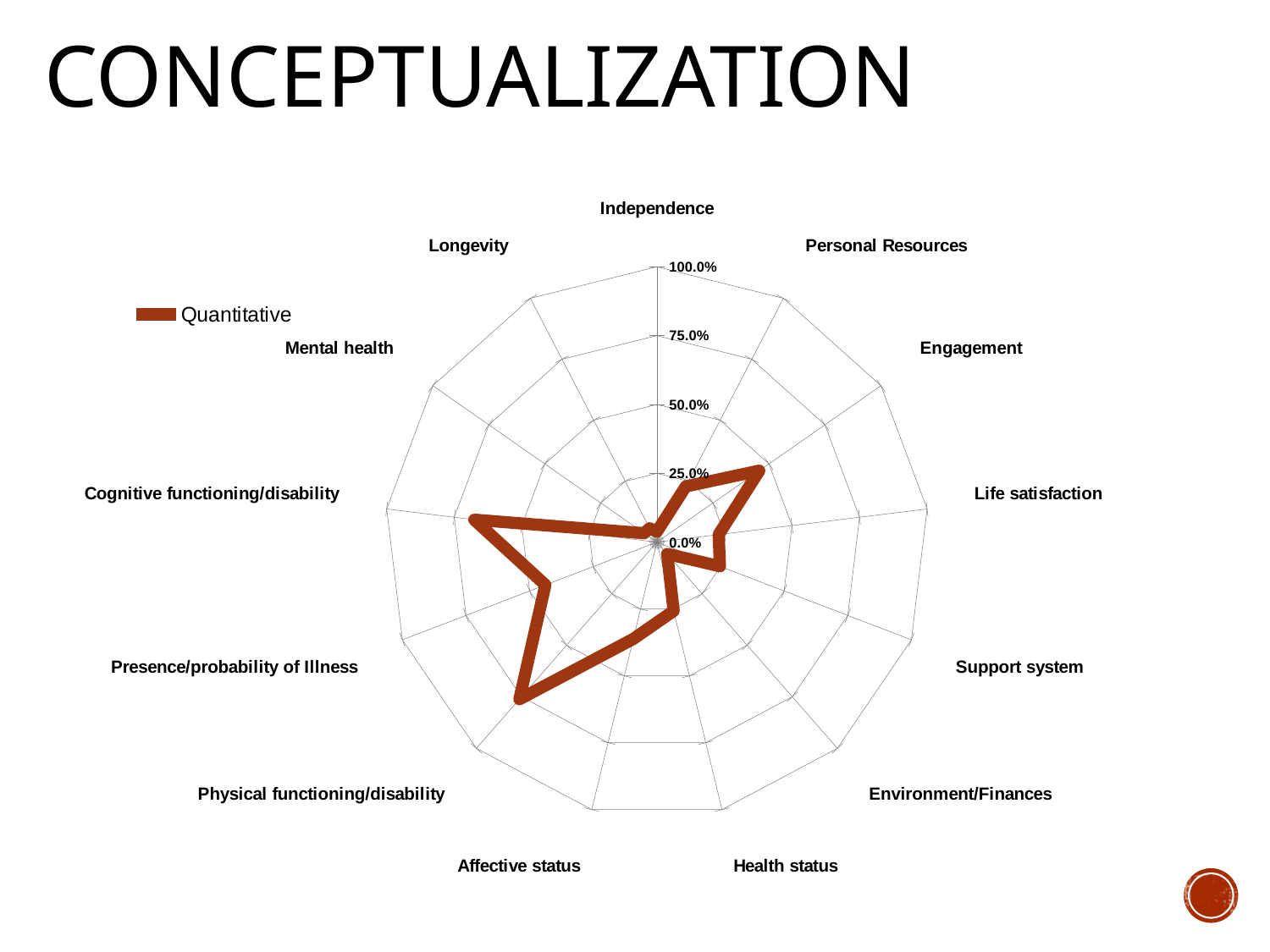
Is the value for Physical functioning/disability greater or less than 50.0%? greater What kind of chart is shown on the slide? Radar chart Is the value for Independence greater or less than 25.0%? less Which has the larger value, Cognitive functioning/disability or Engagement? Cognitive functioning/disability How many series does the legend list? 1 What is the name of the series shown in the legend? Quantitative Is the value for Cognitive functioning/disability greater or less than 50.0%? greater What is the highest value marked on the radar chart's axis scale? 100.0% Which has the larger value, Physical functioning/disability or Health status? Physical functioning/disability How many categories (axes) does the radar chart have? 13